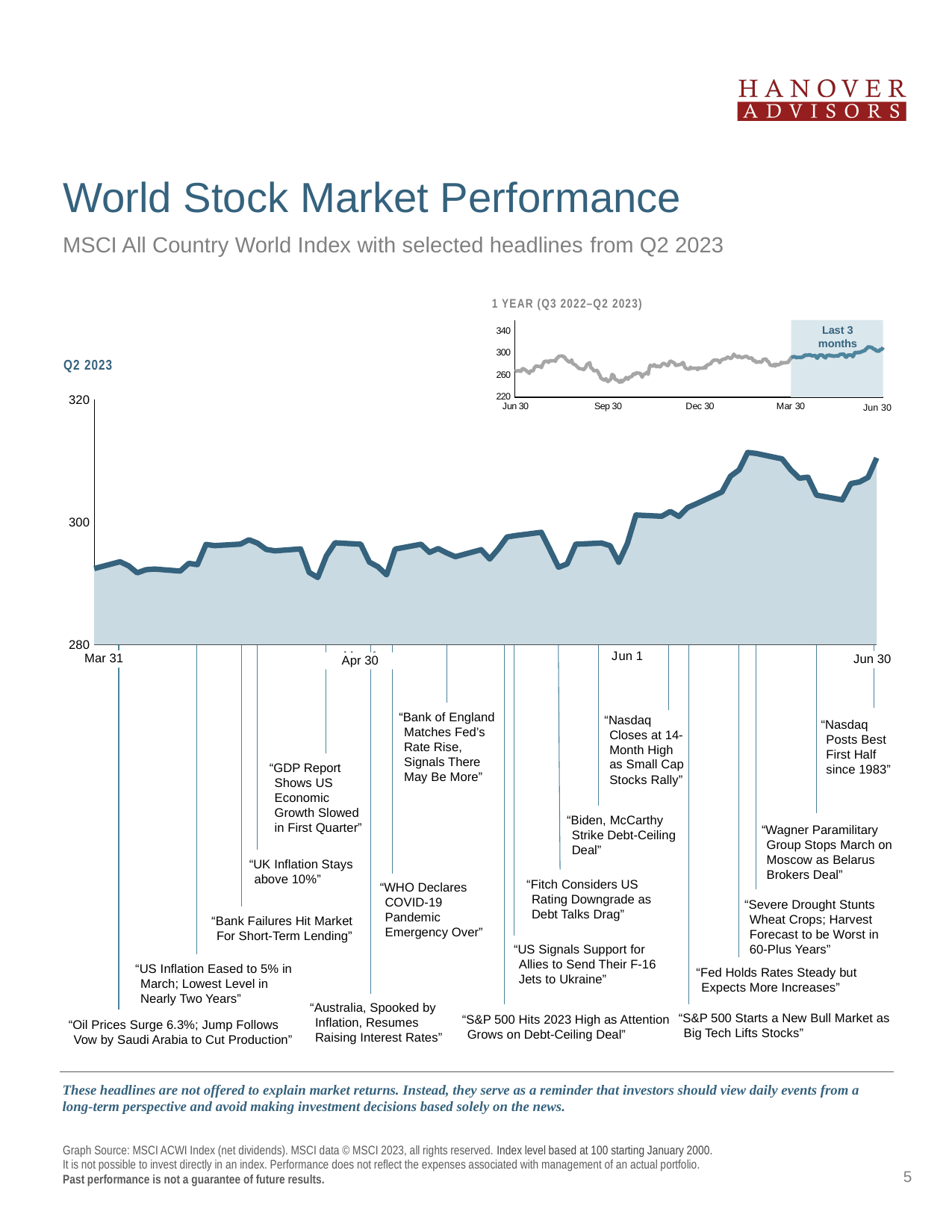
On the main Q2 2023 chart, is the value at Jun 30 greater or less than 300? greater How many date labels are shown on the x axis of the 1 YEAR inset chart? 5 On the main Q2 2023 chart, is the value at Mar 31 greater or less than 300? less On the main Q2 2023 chart, which is higher, the value at Mar 31 or the value at Jun 30? Jun 30 What kind of chart is the main Q2 2023 chart? area chart (a line with the area beneath it shaded) What period does the inset chart's title say it covers? 1 YEAR (Q3 2022–Q2 2023) On the 1 YEAR inset chart, which is higher, the value around Sep 30 or the value at the final Jun 30? Jun 30 On the 1 YEAR inset chart, is the value at Dec 30 greater or less than 260? greater On the main Q2 2023 chart, does the index level overall rise or fall from Mar 31 to Jun 30? rise What is the title of the slide's chart? World Stock Market Performance